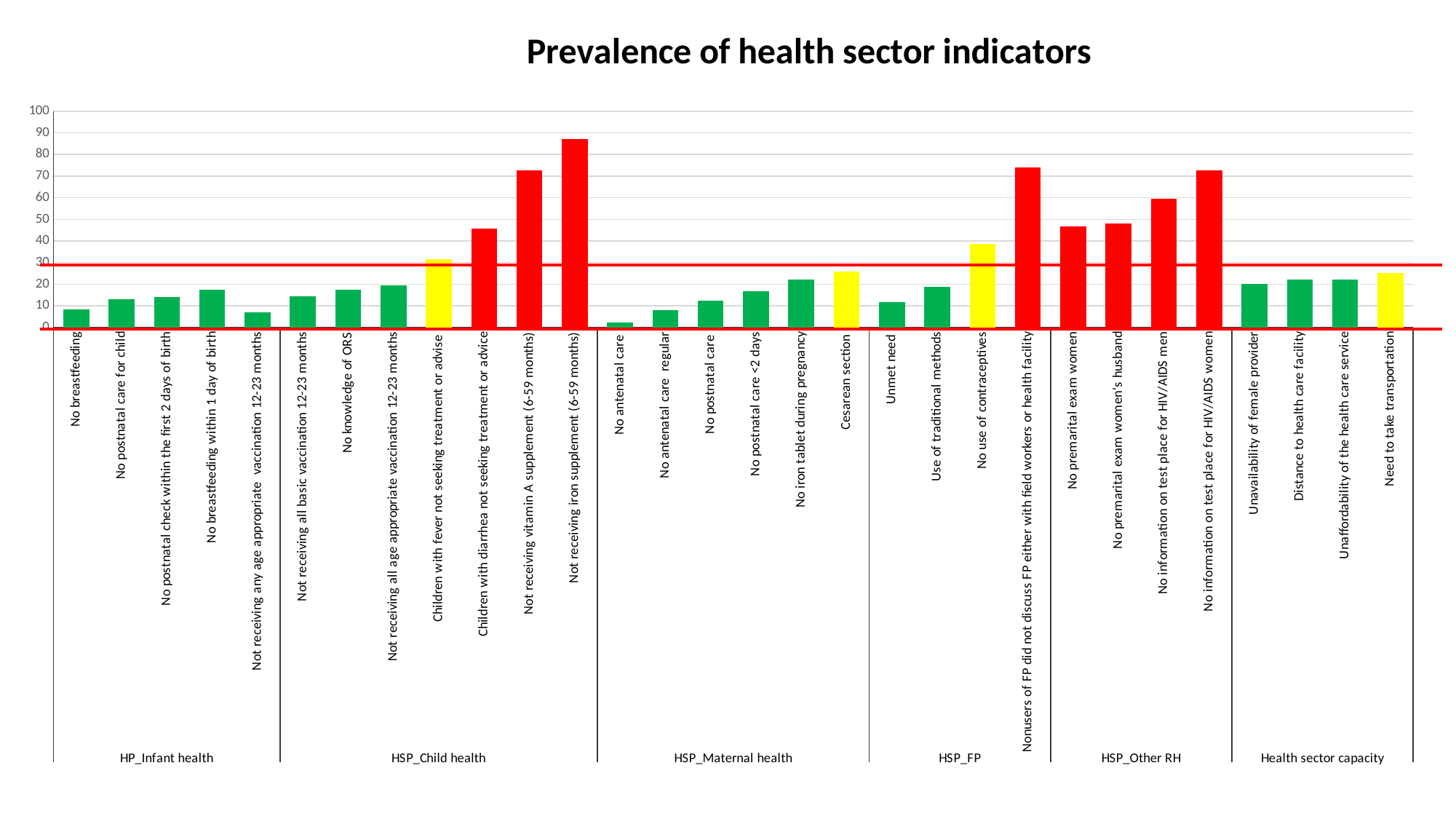
Which is larger: the value for No use of contraceptives or the value for Unmet need? No use of contraceptives Which is larger: the value for Not receiving vitamin A supplement (6-59 months) or the value for Children with diarrhea not seeking treatment or advice? Not receiving vitamin A supplement (6-59 months) Which indicator has the highest bar in the chart? Not receiving iron supplement (6-59 months) Is the value for No antenatal care greater or less than 10? less Is the value for Nonusers of FP did not discuss FP either with field workers or health facility greater or less than 70? greater How many indicator groups (such as HP_Infant health, HSP_Child health) are labelled along the x axis? 6 Is the value for Not receiving iron supplement (6-59 months) greater or less than 80? greater How many bars are plotted in the chart in total? 30 What is the title of the chart? Prevalence of health sector indicators What kind of chart is shown on the slide? bar chart Which indicator has the lowest bar in the chart? No antenatal care